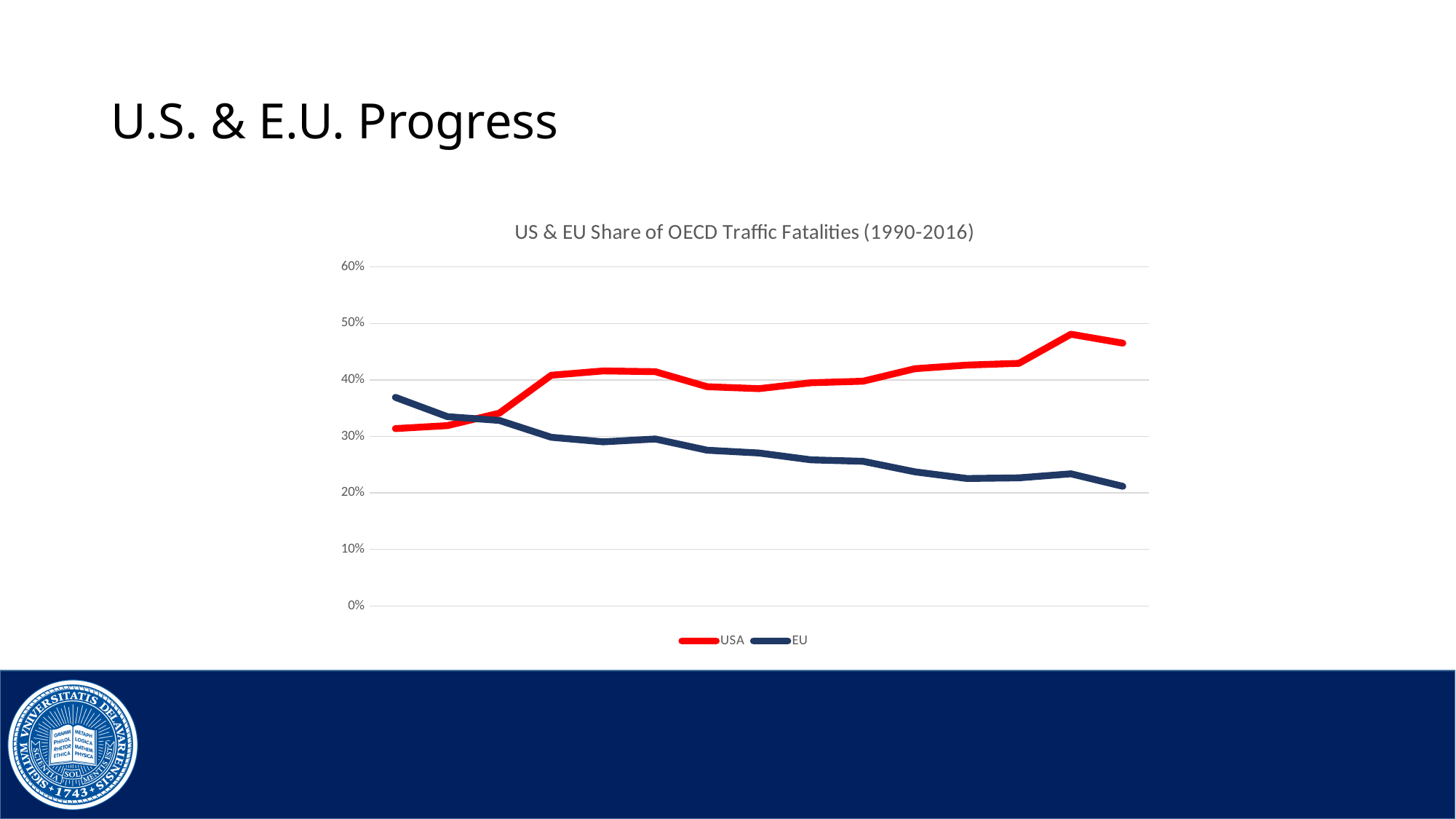
Does the EU line generally rise or fall from left to right across the chart? Fall Is the value for EU at the right end of the chart greater or less than 30%? less What kind of chart is shown on the slide? Line chart Does the USA line generally rise or fall from left to right across the chart? Rise Is the value for EU at the left end of the chart greater or less than 30%? greater Is the value for USA at the right end of the chart greater or less than 40%? greater At the right end of the chart, which series has the larger value, USA or EU? USA At the left end of the chart, which series has the larger value, USA or EU? EU How many series does the legend of the chart list? 2 Which series is drawn in red in the chart? USA What is the title of the chart? US & EU Share of OECD Traffic Fatalities (1990-2016)